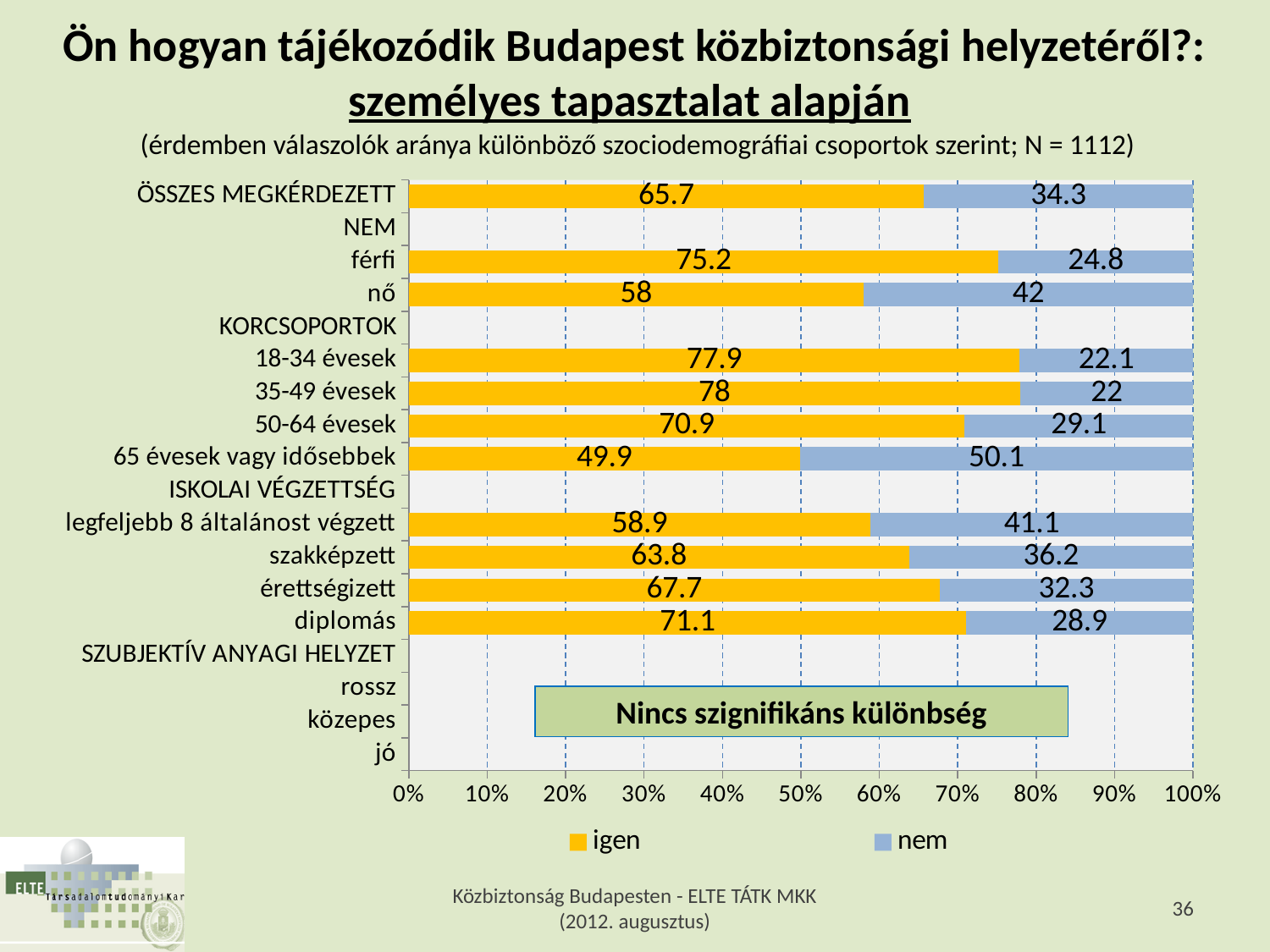
What is the "nem" value for férfi? 24.8 What is the "igen" value for ÖSSZES MEGKÉRDEZETT? 65.7 What is the total of the stacked bar for ÖSSZES MEGKÉRDEZETT? 100 What kind of chart is shown on the slide? bar chart What is the difference between the "igen" values for férfi and nő? 17.2 How many series does the legend list? 2 Which has a larger "igen" value, diplomás or érettségizett? diplomás What is the "nem" value for szakképzett? 36.2 Which category has the lowest "igen" value? 65 évesek vagy idősebbek What text is shown in the box over the SZUBJEKTÍV ANYAGI HELYZET rows? Nincs szignifikáns különbség Which category has the highest "nem" value? 65 évesek vagy idősebbek What is the "igen" value for 50-64 évesek? 70.9